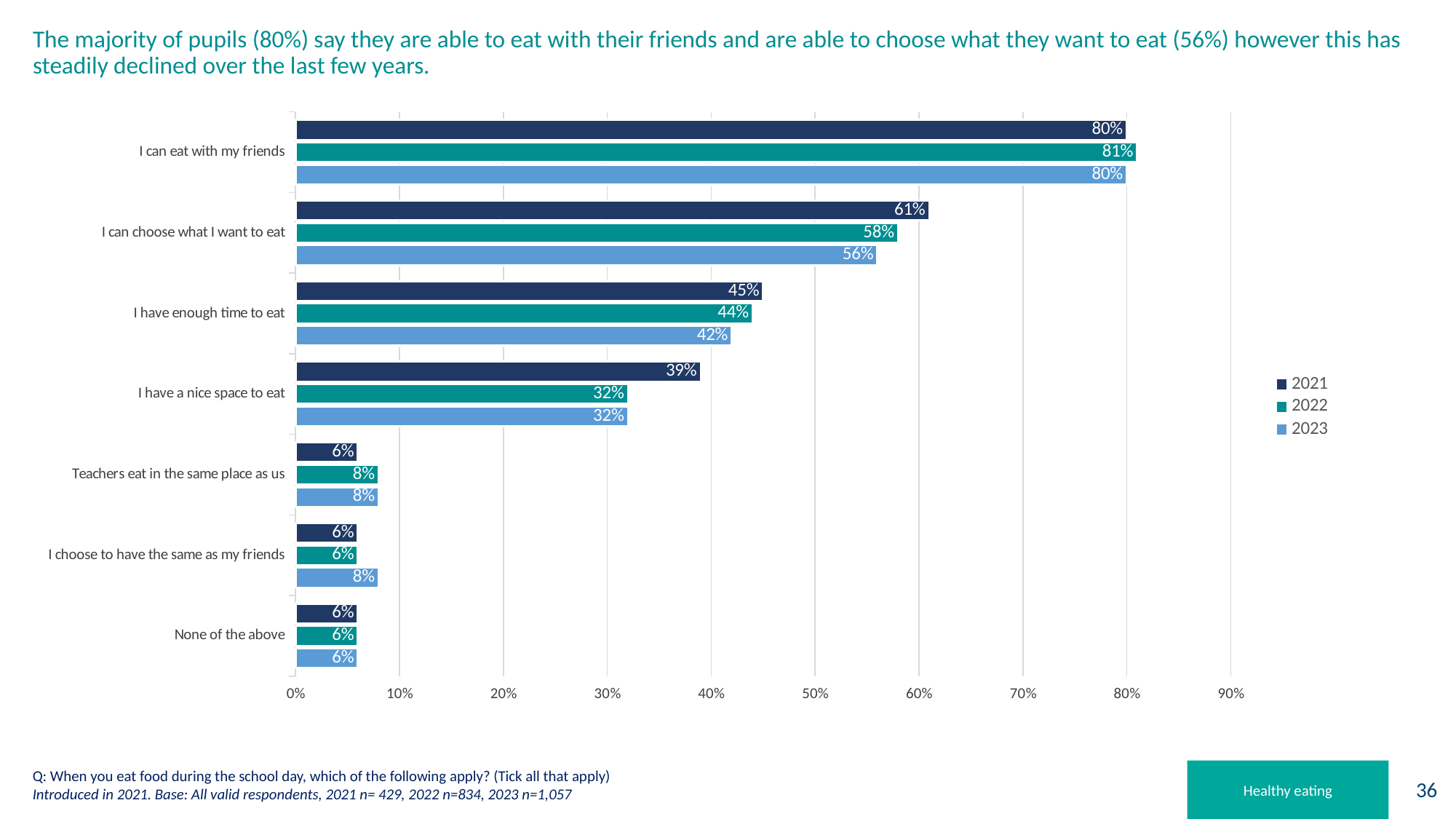
Which category has the lowest value in 2023? None of the above What is the difference between the 2021 and 2023 values for 'I can choose what I want to eat'? 5% How many series does the legend list? 3 Which category has the highest value in 2023? I can eat with my friends Did the value for 'I have enough time to eat' rise or fall from 2021 to 2023? Fall What kind of chart is shown on the slide? Bar chart What percentage of pupils said 'I can eat with my friends' in 2022? 81% Which years are listed in the chart legend? 2021, 2022, 2023 How many categories are shown on the chart? 7 Which is larger for 'I have a nice space to eat': the 2021 value or the 2022 value? 2021 What is the 2021 value for 'I have a nice space to eat'? 39% What is the 2023 value for 'I can choose what I want to eat'? 56%